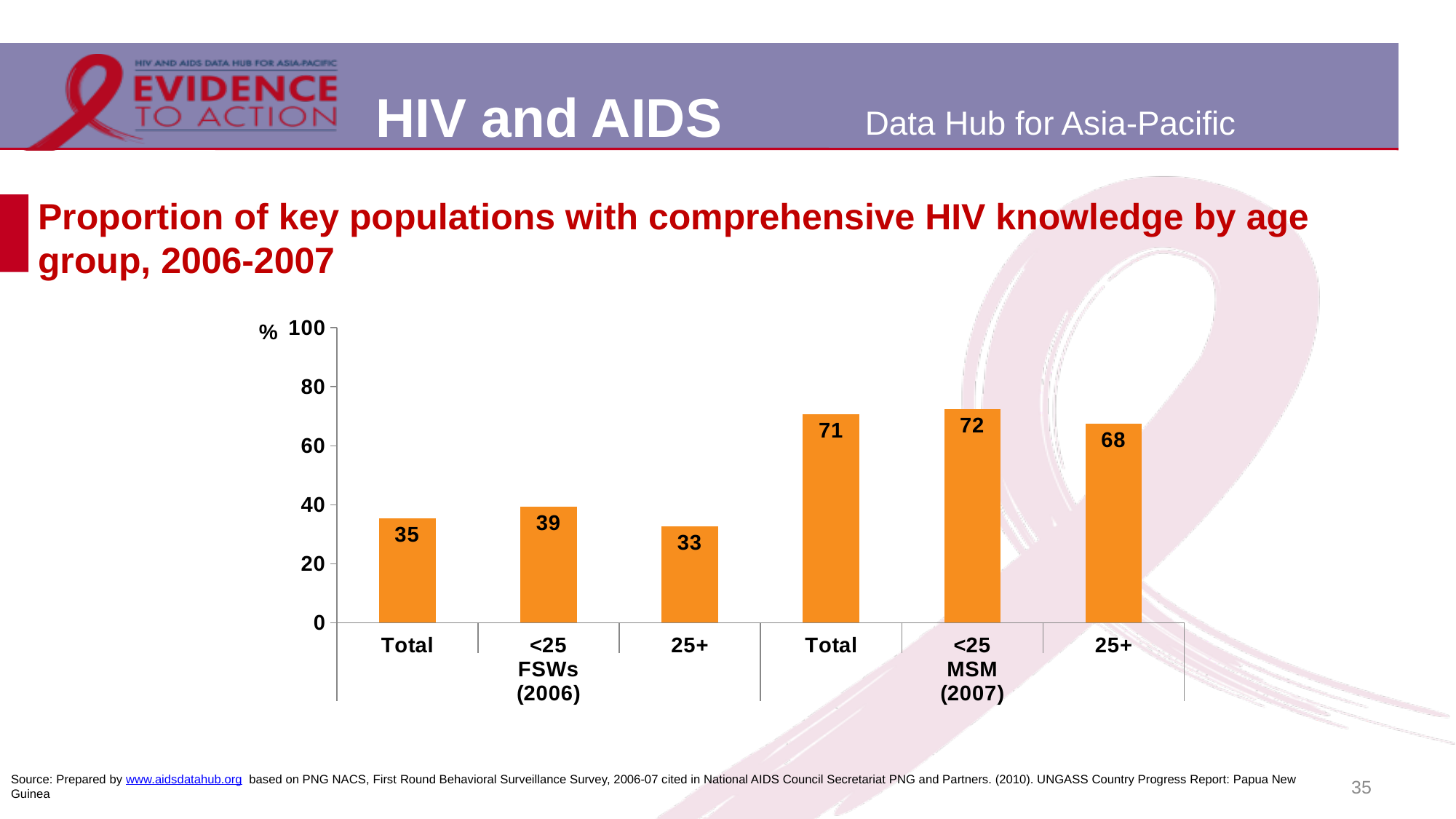
What is the value for the <25 age group among MSM (2007)? 72 Which bar has the lowest value on the chart? 25+ FSWs (2006) What is the value for the 25+ age group among FSWs (2006)? 33 What is the value for the Total bar in the FSWs (2006) group? 35 What is the difference between the Total for MSM (2007) and the Total for FSWs (2006)? 36 What unit is shown on the y axis of the chart? % Which is larger: the value for <25 FSWs (2006) or the value for 25+ FSWs (2006)? <25 FSWs (2006) What is the difference between the <25 and 25+ values for MSM (2007)? 4 What kind of chart is shown on the slide? Bar chart Is the value for 25+ MSM (2007) greater or less than 60? greater How many bars are plotted on the chart? 6 Which bar has the highest value on the chart? <25 MSM (2007)